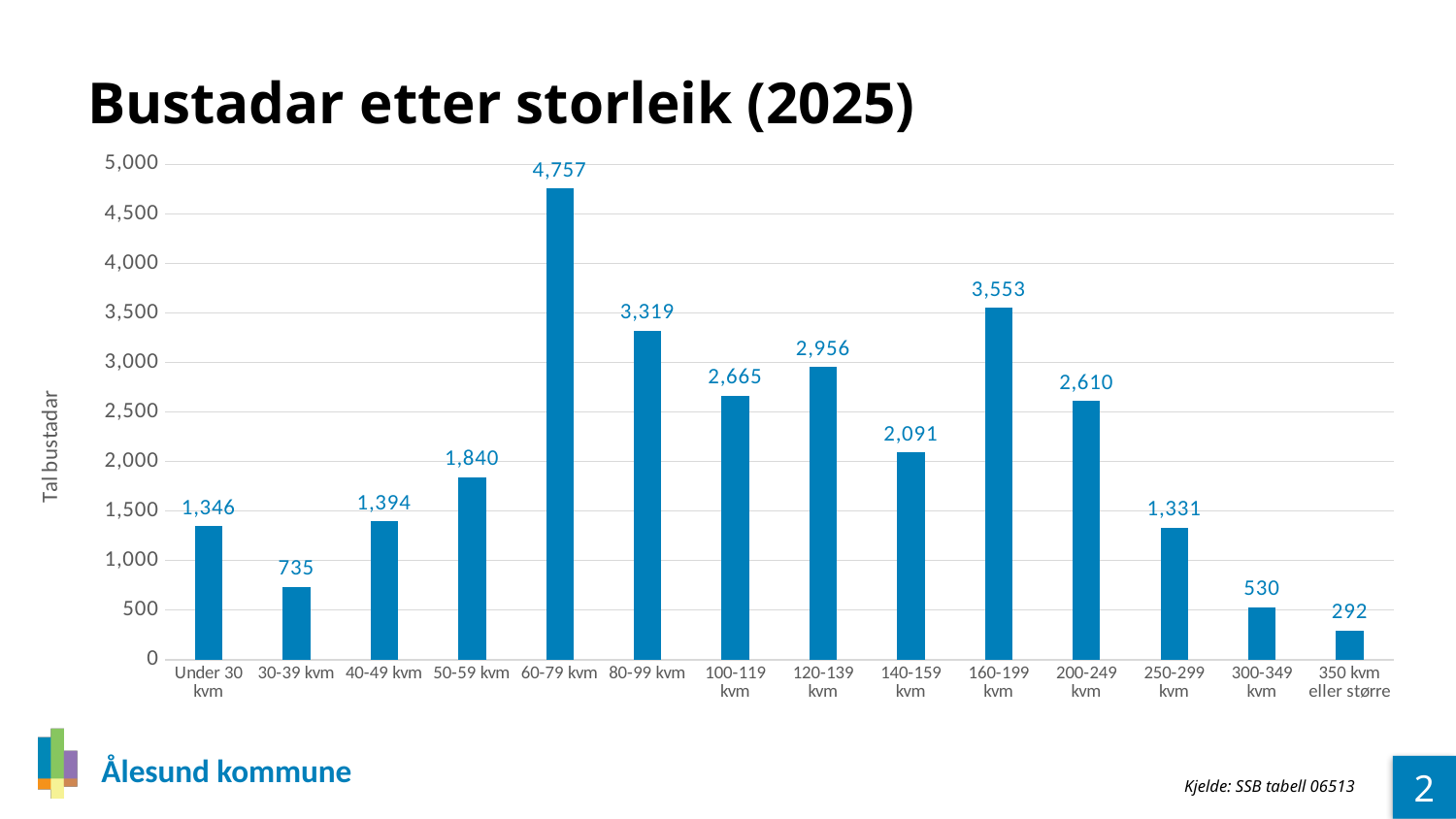
Which size category has the lowest number of dwellings? 350 kvm eller større Which size category has the highest number of dwellings? 60-79 kvm How many size categories are shown on the x axis? 14 Is the value for 80-99 kvm greater or less than 3,000? greater What is the value for 160-199 kvm? 3,553 What is the value for 350 kvm eller større? 292 What is the value for 60-79 kvm? 4,757 What is the difference between the values for 60-79 kvm and 160-199 kvm? 1,204 What is the label on the vertical axis? Tal bustadar Which is larger, the value for 120-139 kvm or the value for 100-119 kvm? 120-139 kvm What is the difference between the values for 300-349 kvm and 350 kvm eller større? 238 What kind of chart is shown on the slide? bar chart